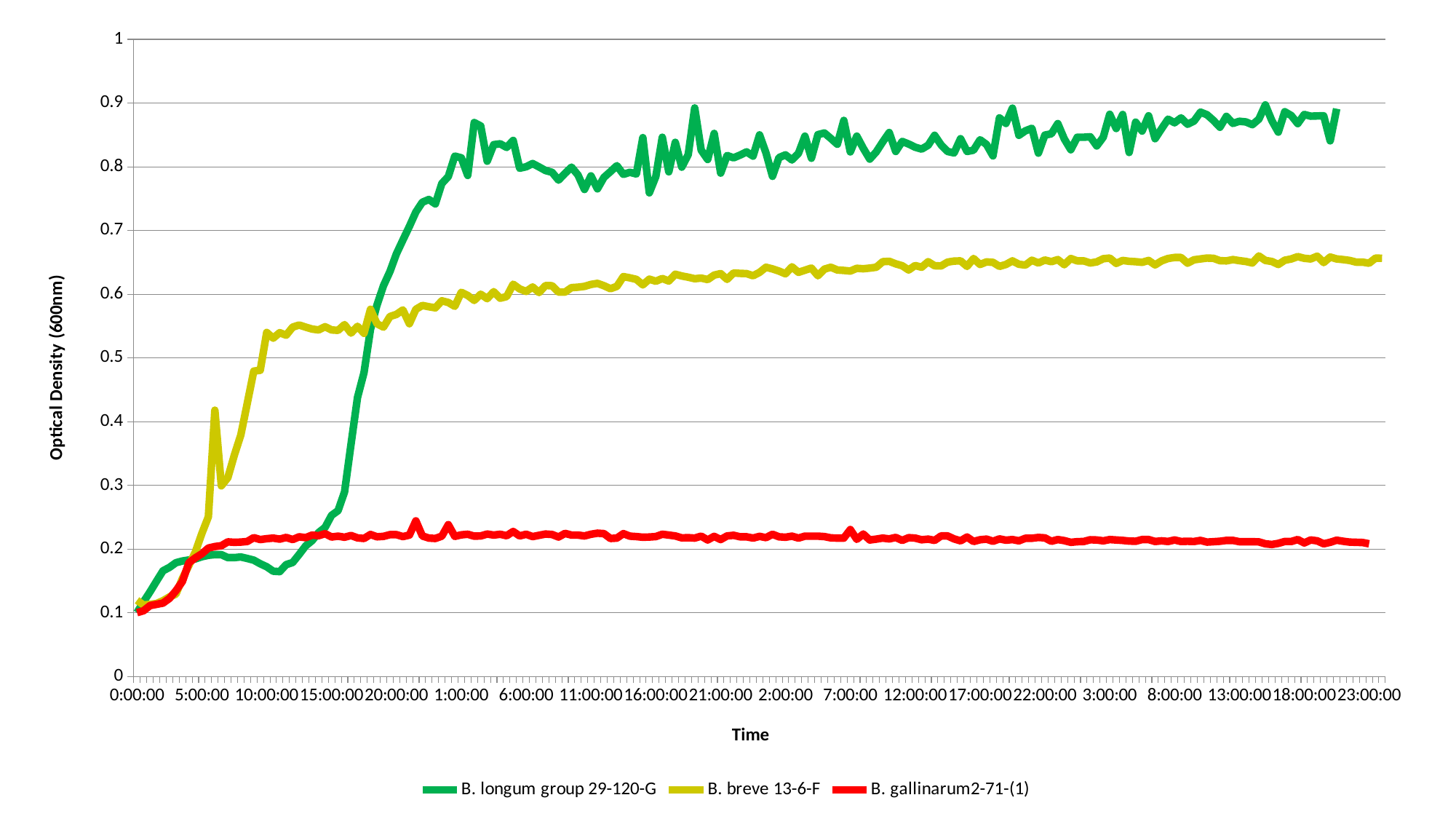
What kind of chart is shown on the slide? line chart At 10:00:00, which series has the higher optical density, B. breve 13-6-F or B. longum group 29-120-G? B. breve 13-6-F Which series reaches the highest optical density by the end of the time axis? B. longum group 29-120-G What is the title of the vertical axis? Optical Density (600nm) Is the value for B. breve 13-6-F at 23:00:00 greater or less than 0.7? less Which series is drawn in red? B. gallinarum2-71-(1) Which series has the lowest optical density at 23:00:00? B. gallinarum2-71-(1) How many series does the legend list? 3 Is the value for B. gallinarum2-71-(1) at 12:00:00 greater or less than 0.3? less At 6:00:00, which series has the higher optical density, B. longum group 29-120-G or B. gallinarum2-71-(1)? B. longum group 29-120-G Does the optical density of B. breve 13-6-F generally rise or fall over the time axis? rise